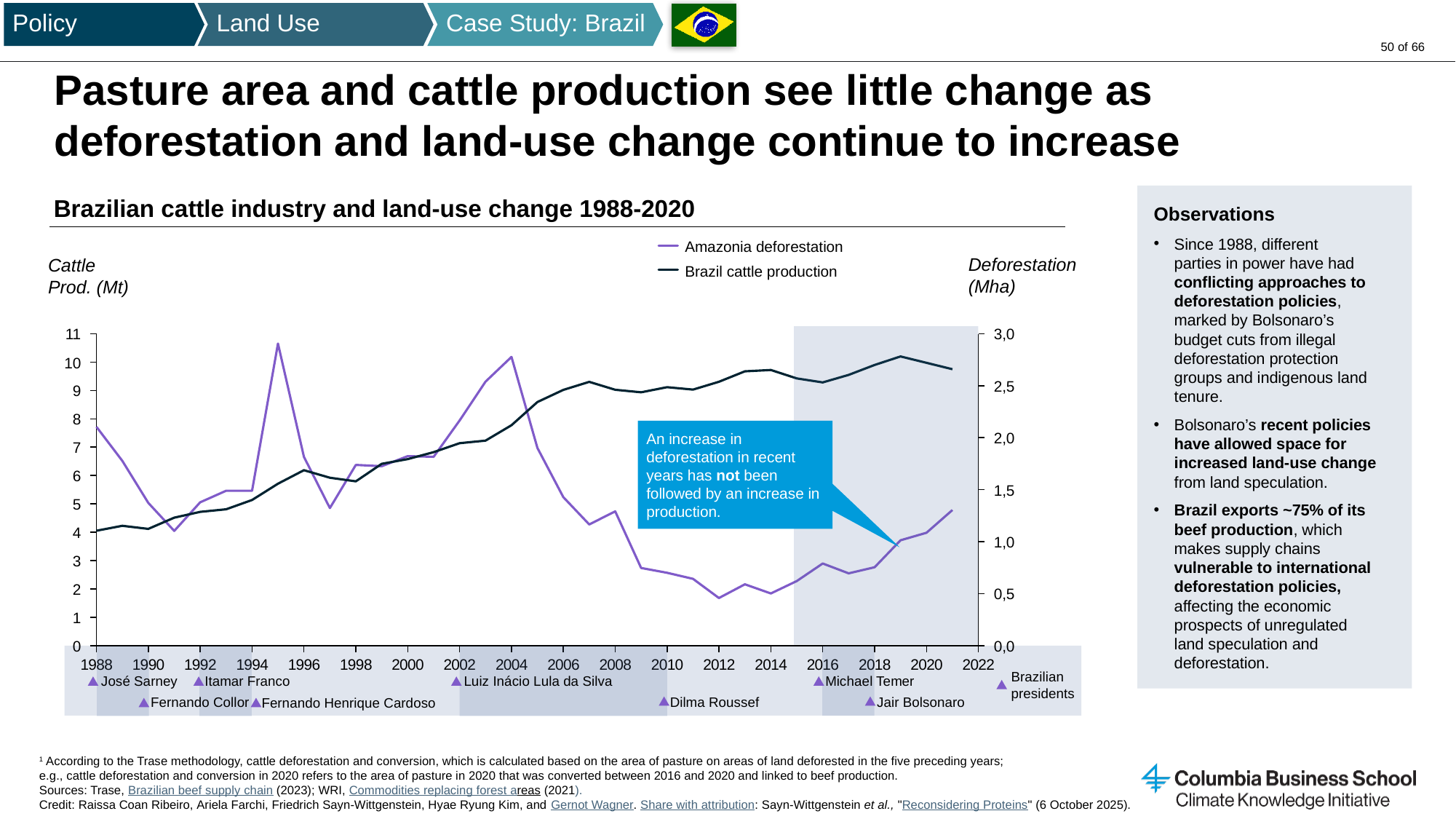
Is the Amazonia deforestation value for 2012 greater or less than 1,0 Mha? less Is Brazil cattle production higher in 1988 or in 2019? 2019 What kind of chart is shown on the slide? line chart Is the Brazil cattle production value for 1988 greater or less than 5 Mt? less Is the Brazil cattle production value for 2019 greater or less than 9 Mt? greater Does Brazil cattle production generally rise or fall from 1988 to 2021? rise Which series is drawn in purple? Amazonia deforestation How many series does the chart legend list? 2 What is the title of the chart? Brazilian cattle industry and land-use change 1988-2020 In which year does Amazonia deforestation reach its highest value on the chart? 1995